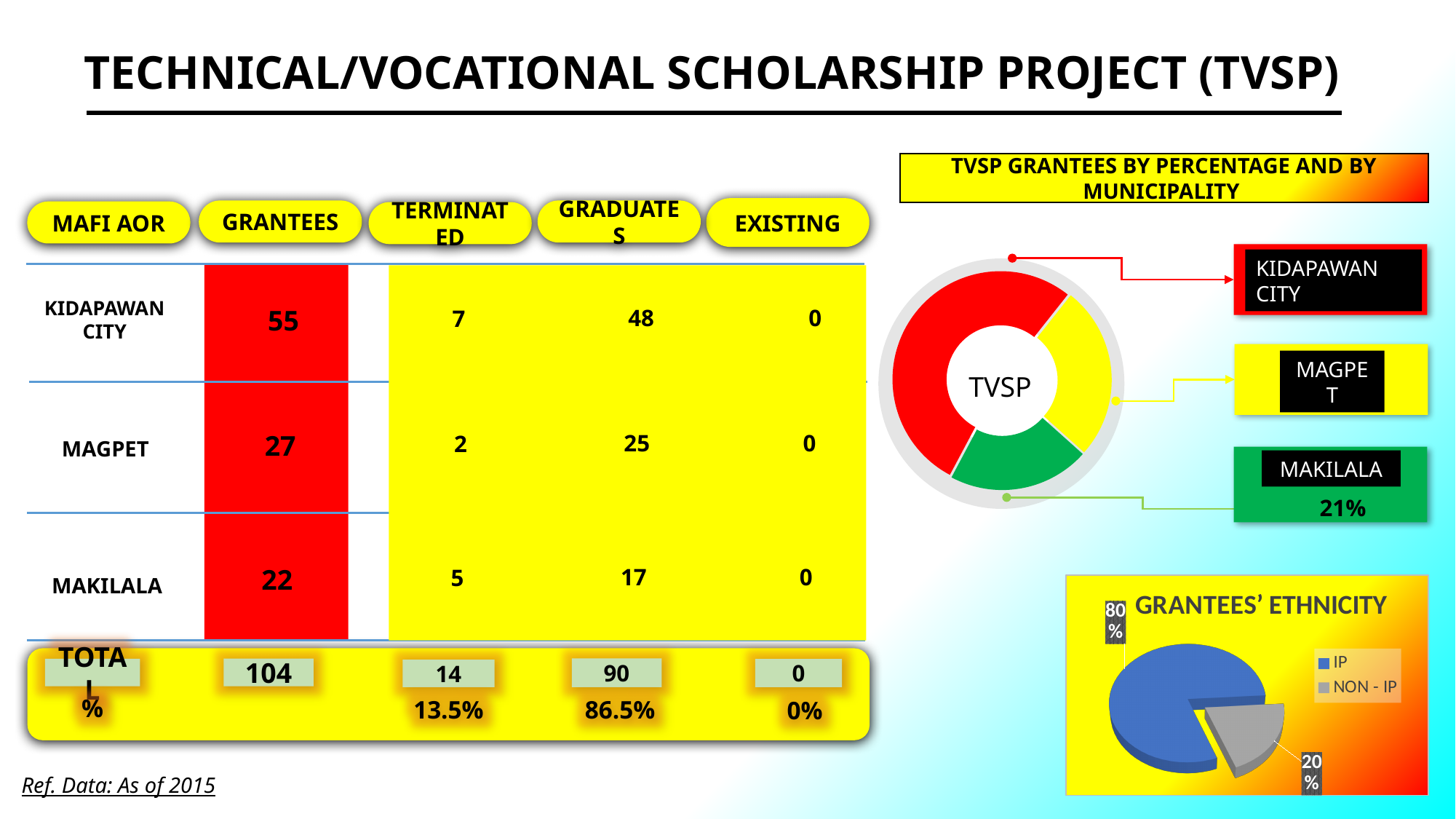
In the TVSP GRANTEES BY PERCENTAGE AND BY MUNICIPALITY chart, which colour represents Magpet? Yellow In the TVSP GRANTEES BY PERCENTAGE AND BY MUNICIPALITY chart, which municipality has the largest share? Kidapawan City In the GRANTEES' ETHNICITY chart, what percentage of grantees are IP? 80% In the GRANTEES' ETHNICITY chart, which category has the larger share? IP How many municipalities are shown in the TVSP GRANTEES BY PERCENTAGE AND BY MUNICIPALITY chart? 3 In the TVSP GRANTEES BY PERCENTAGE AND BY MUNICIPALITY chart, what percentage is shown for Makilala? 21% In the TVSP GRANTEES BY PERCENTAGE AND BY MUNICIPALITY chart, which has the larger share, Kidapawan City or Makilala? Kidapawan City In the GRANTEES' ETHNICITY chart, what is the difference in percentage points between IP and NON - IP? 60% In the GRANTEES' ETHNICITY chart, what percentage of grantees are NON - IP? 20% How many categories does the legend of the GRANTEES' ETHNICITY chart list? 2 What kind of chart is the GRANTEES' ETHNICITY chart? Pie chart What text appears in the centre of the TVSP GRANTEES BY PERCENTAGE AND BY MUNICIPALITY donut chart? TVSP